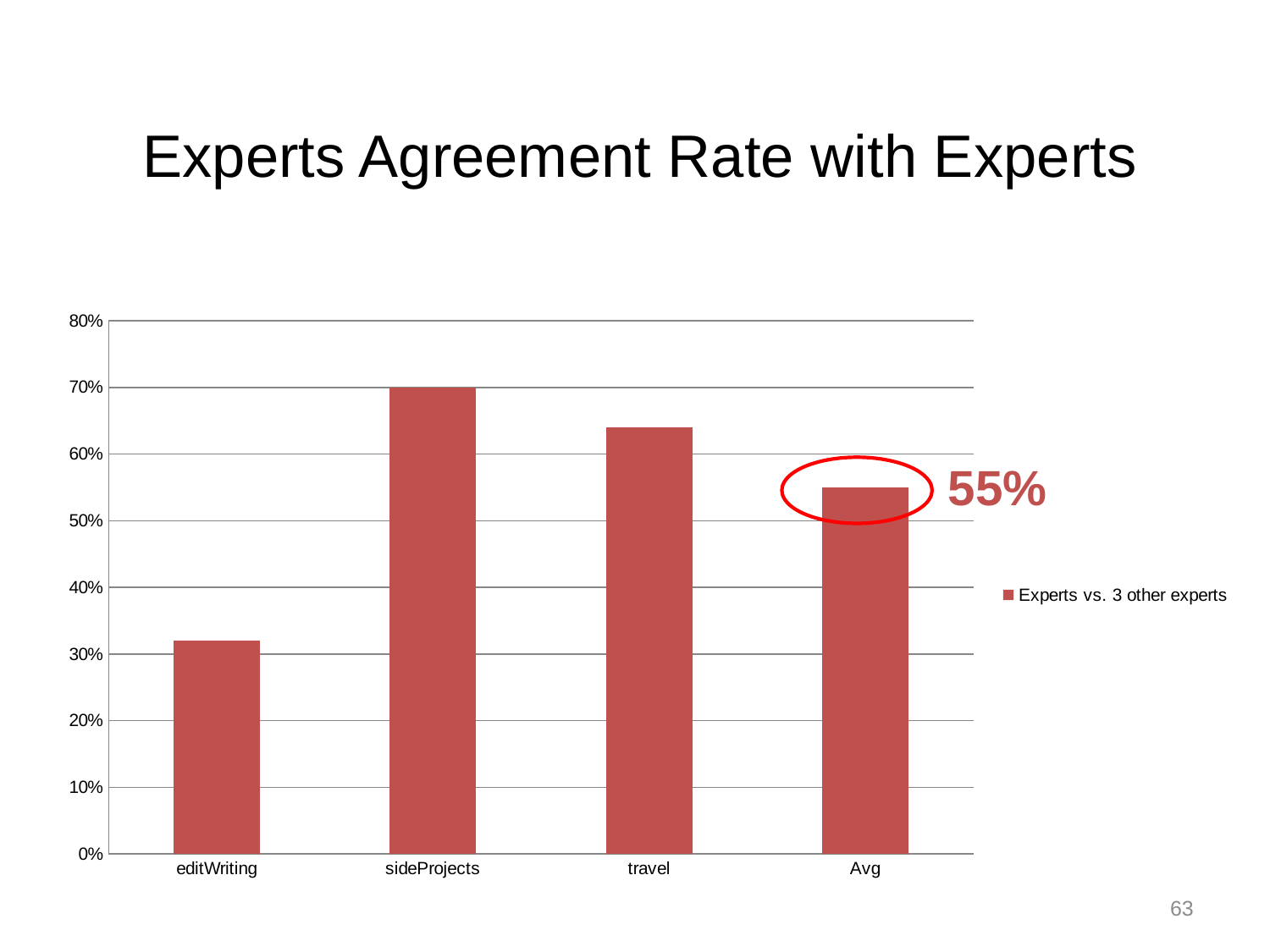
Which category has the highest value? sideProjects What is the value for sideProjects? 70% What kind of chart is shown on the slide? bar chart Which is larger, the value for travel or the value for editWriting? travel How many series does the legend list? 1 Which is larger, the value for sideProjects or the value for travel? sideProjects Is the value for travel greater or less than 60%? greater How many categories are shown on the x axis? 4 Which category has the lowest value? editWriting Is the value for editWriting greater or less than 40%? less What is the legend entry for the series shown? Experts vs. 3 other experts What is the value for Avg? 55%